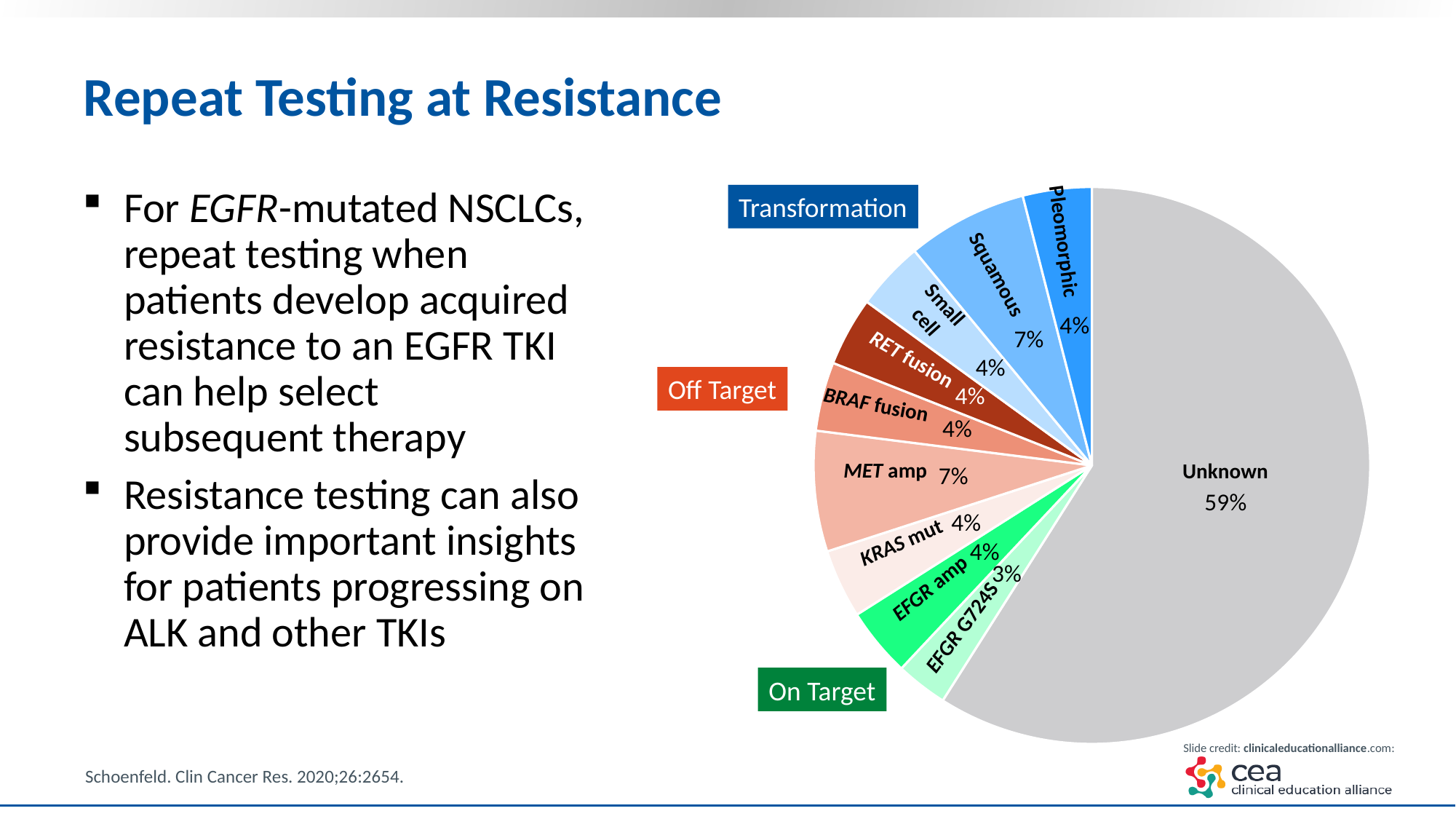
Which slice of the pie is the largest? Unknown What percentage is shown for the MET amp slice? 7% Which group label is shown next to the green slices of the pie? On Target Which slice of the pie is the smallest? EFGR G724S What share of the pie is labelled Unknown? 59% What percentage is shown for the EFGR G724S slice? 3% How many slices does the pie chart have? 10 Which is larger, the Squamous slice or the Pleomorphic slice? Squamous What is the difference in percentage points between the Unknown slice and the MET amp slice? 52 What kind of chart is shown on the slide? pie chart What percentage is shown for the Squamous slice? 7% What percentage is shown for the KRAS mut slice? 4%